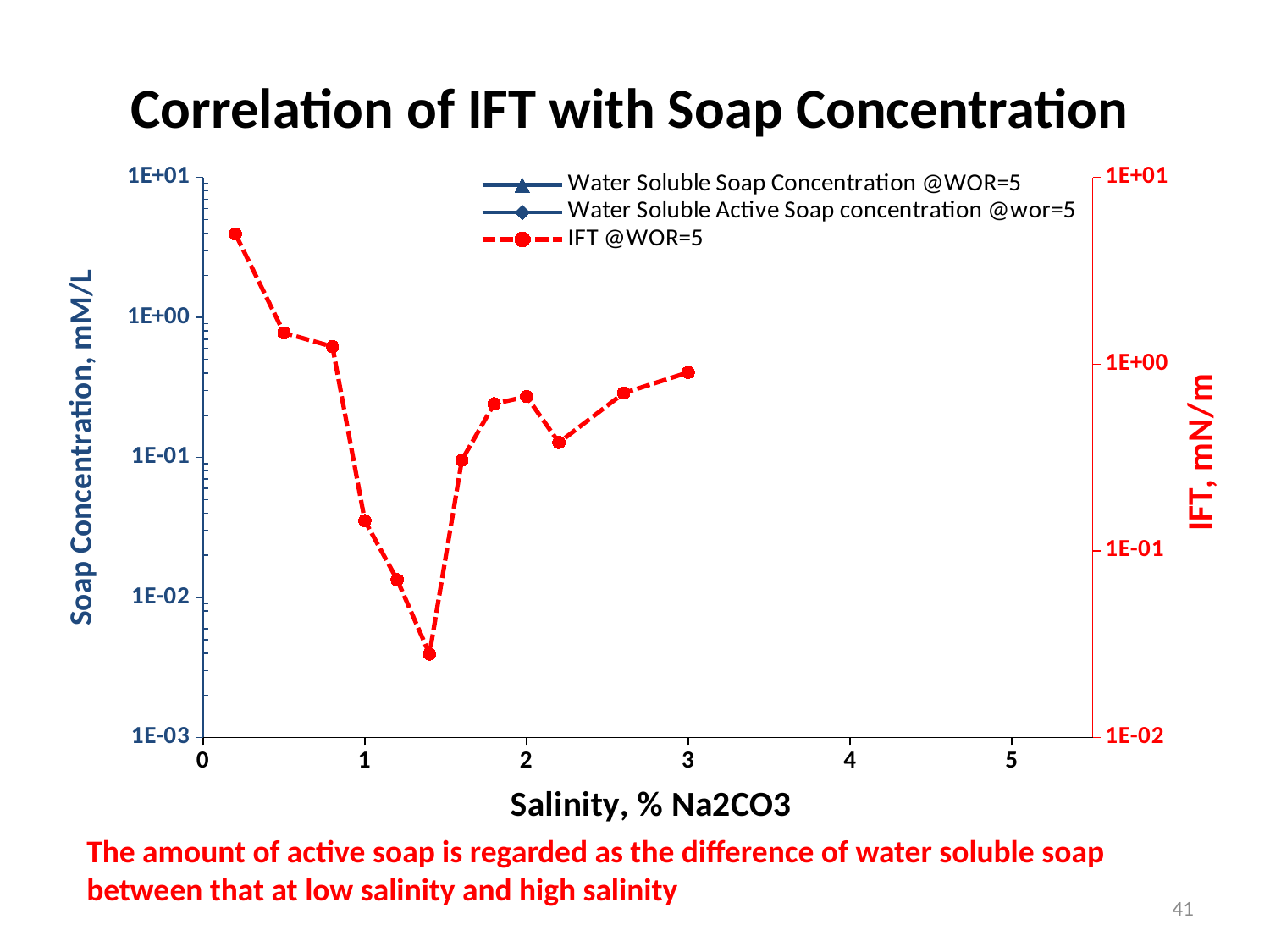
What is the title of the chart? Correlation of IFT with Soap Concentration Does the IFT @WOR=5 line rise or fall as salinity increases from 0.2 to 1.4? fall Is the IFT @WOR=5 value at salinity 0.2 greater or less than 1E+00 on the right axis? greater What kind of chart is shown on the slide? line chart How many data points are plotted on the IFT @WOR=5 line? 12 Which has the larger IFT @WOR=5 value: salinity 0.2 or salinity 3? salinity 0.2 Is the IFT @WOR=5 value at salinity 1.4 greater or less than 1E-01 on the right axis? less What is the title of the x axis? Salinity, % Na2CO3 Does the IFT @WOR=5 line rise or fall as salinity increases from 1.4 to 2? rise How many series does the chart legend list? 3